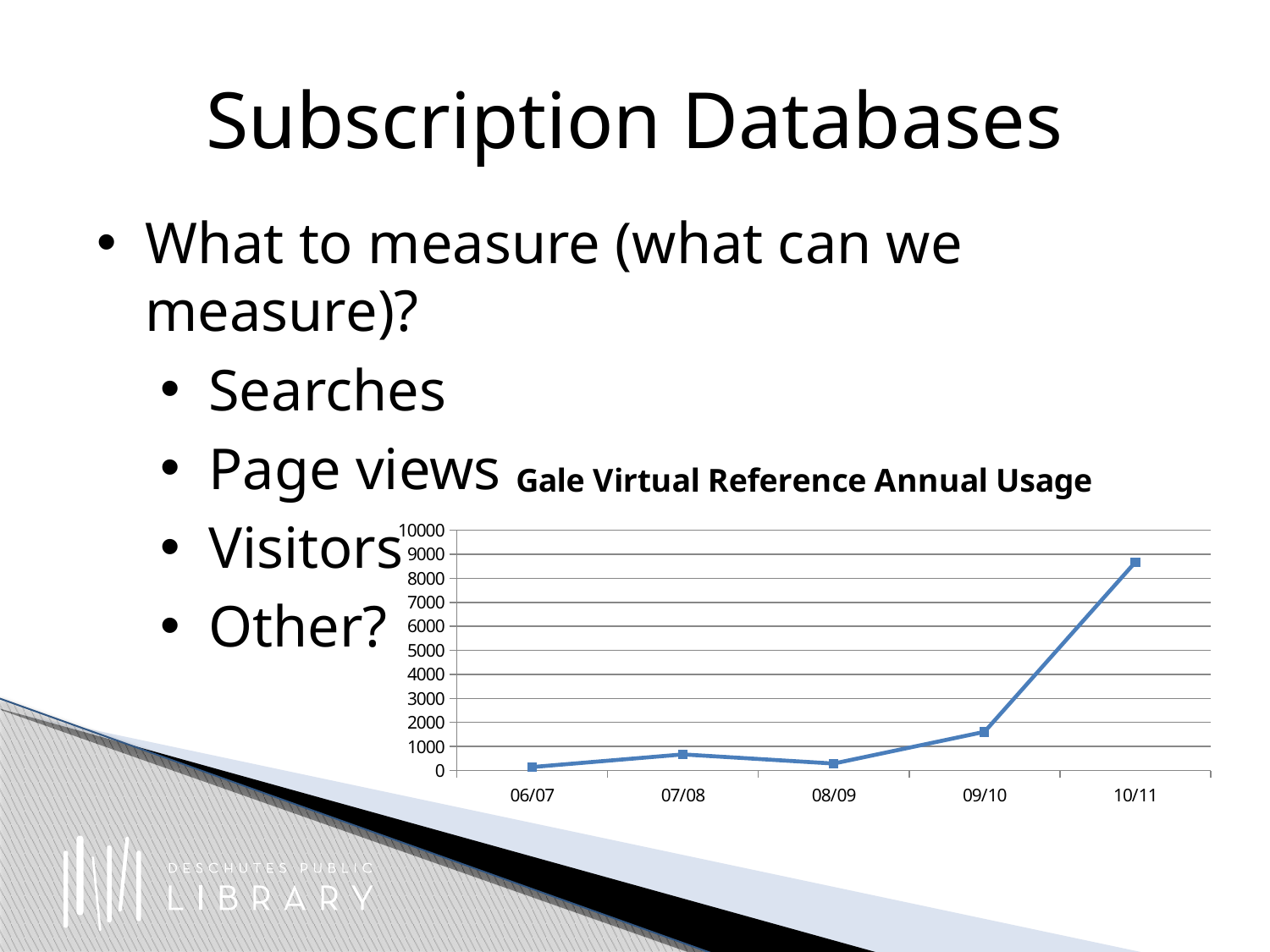
Is the value for 10/11 greater or less than 9000? less Does the usage rise or fall between 09/10 and 10/11? rise Which is larger, the value for 07/08 or the value for 08/09? 07/08 Which year has the highest usage in the chart? 10/11 How many years are plotted on the x axis of the chart? 5 What kind of chart is shown on the slide? line chart Is the value for 09/10 greater or less than 2000? less Is the value for 10/11 greater or less than 8000? greater Which year has the lowest usage in the chart? 06/07 What is the title of the chart? Gale Virtual Reference Annual Usage Which is larger, the value for 09/10 or the value for 10/11? 10/11